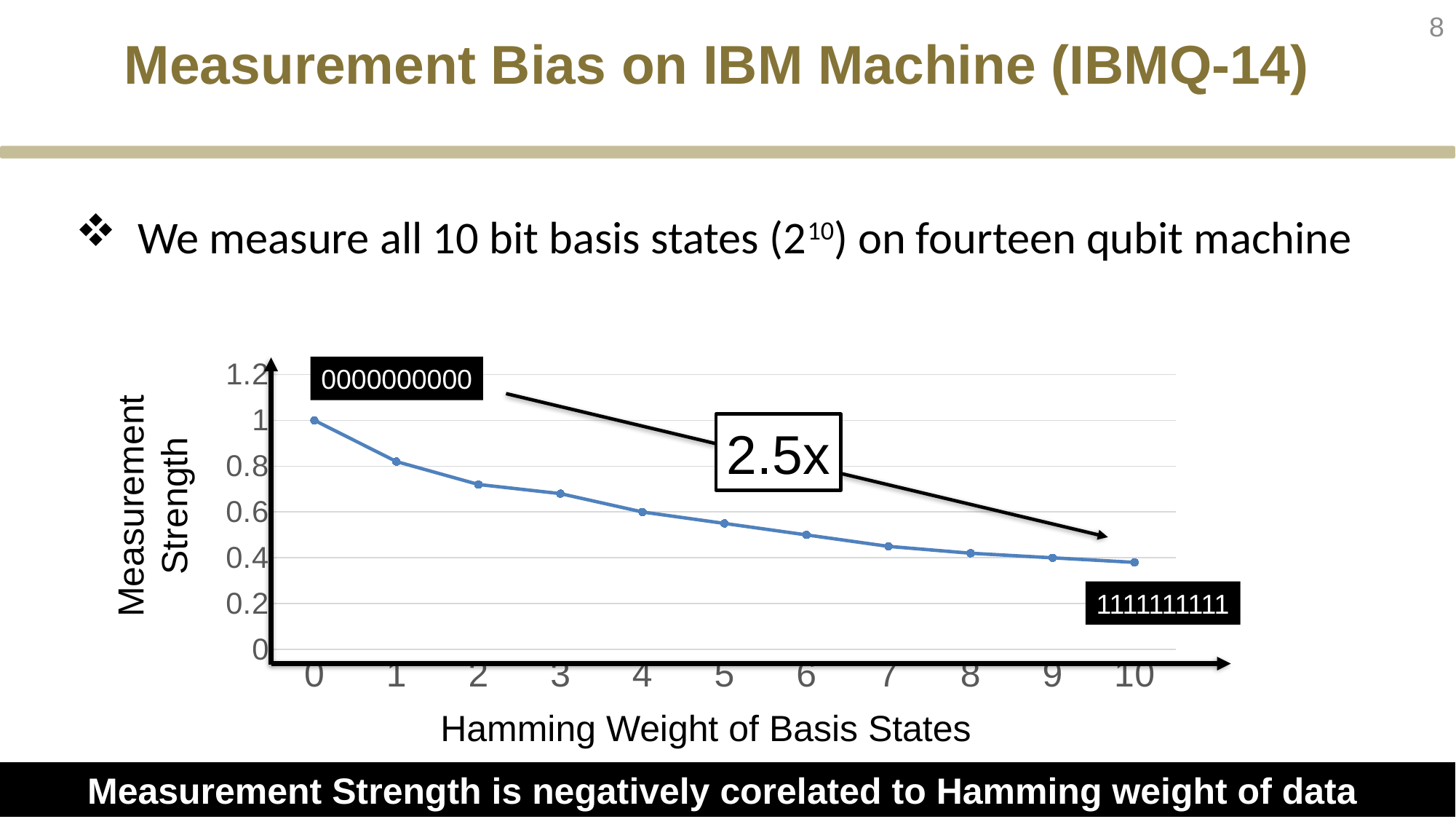
Do the Measurement Strength values rise or fall as Hamming weight increases? fall How many data points are plotted on the line? 11 Is the Measurement Strength at Hamming weight 2 greater or less than 0.6? greater Which Hamming weight has the highest Measurement Strength? 0 Is the Measurement Strength at Hamming weight 2 greater or less than 0.8? less Which Hamming weight has the lowest Measurement Strength? 10 What ratio is written in the annotation box over the chart? 2.5x What is the Measurement Strength at Hamming weight 0? 1 Which has the larger Measurement Strength, Hamming weight 1 or Hamming weight 8? Hamming weight 1 Is the Measurement Strength at Hamming weight 7 greater or less than 0.6? less What kind of chart is shown on the slide? line chart What is the title of the x axis? Hamming Weight of Basis States